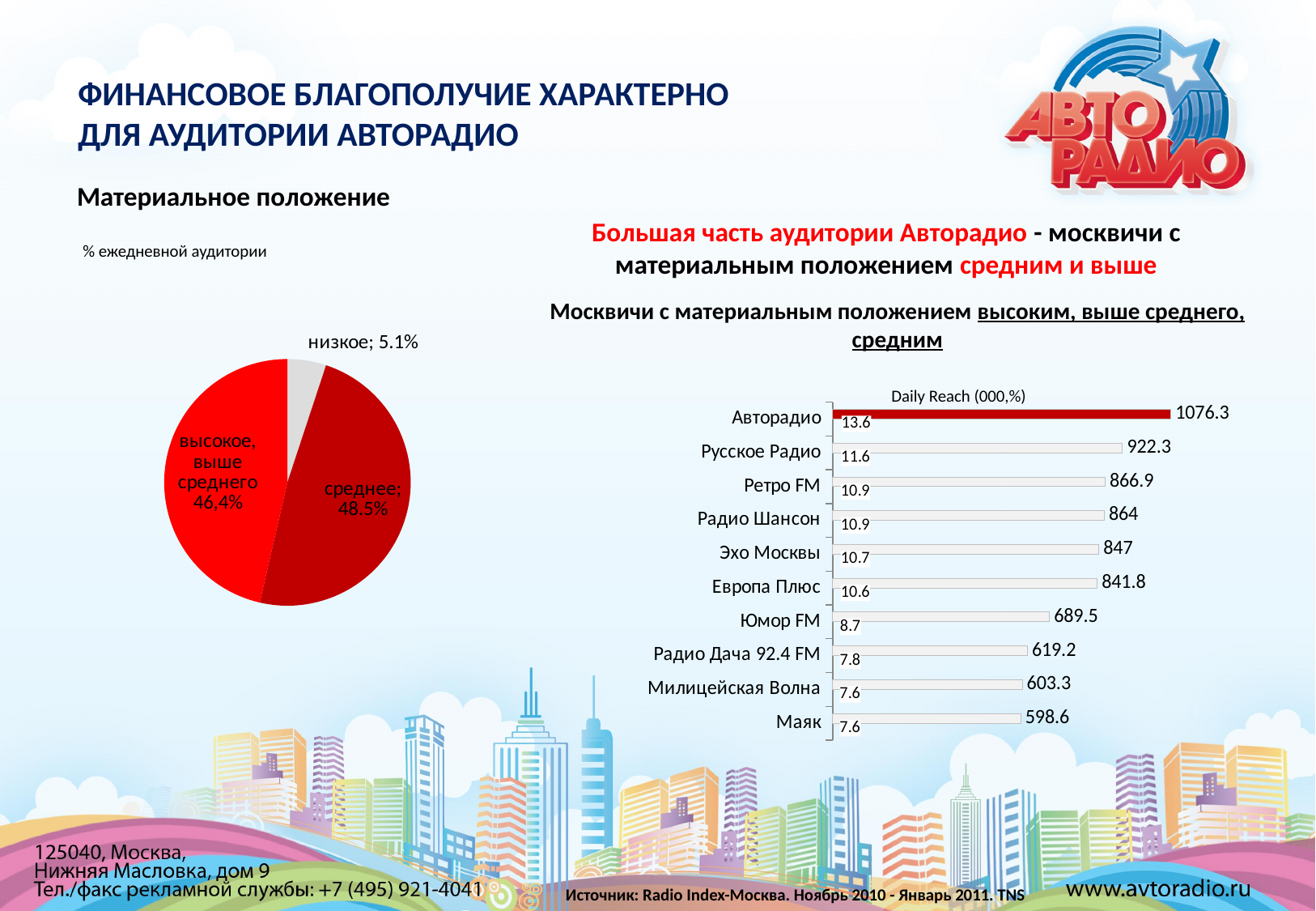
In the pie chart on the left, which slice is the smallest? низкое What type of chart is the Daily Reach chart on the right? bar chart In the pie chart on the left, which slice is the largest? среднее In the pie chart on the left, what share of the daily audience has an average (среднее) financial status? 48.5% In the Daily Reach bar chart on the right, what is the reach in thousands for Авторадио? 1076.3 In the Daily Reach bar chart on the right, what is the difference in thousands between Авторадио and Русское Радио? 154 In the Daily Reach bar chart on the right, how many radio stations are listed? 10 In the pie chart on the left, what share of the daily audience has a low (низкое) financial status? 5.1% In the pie chart on the left, how many slices are there? 3 In the Daily Reach bar chart on the right, which station has the highest reach? Авторадио In the Daily Reach bar chart on the right, what is the percentage value shown for Русское Радио? 11.6 In the Daily Reach bar chart on the right, which station has the lowest reach? Маяк